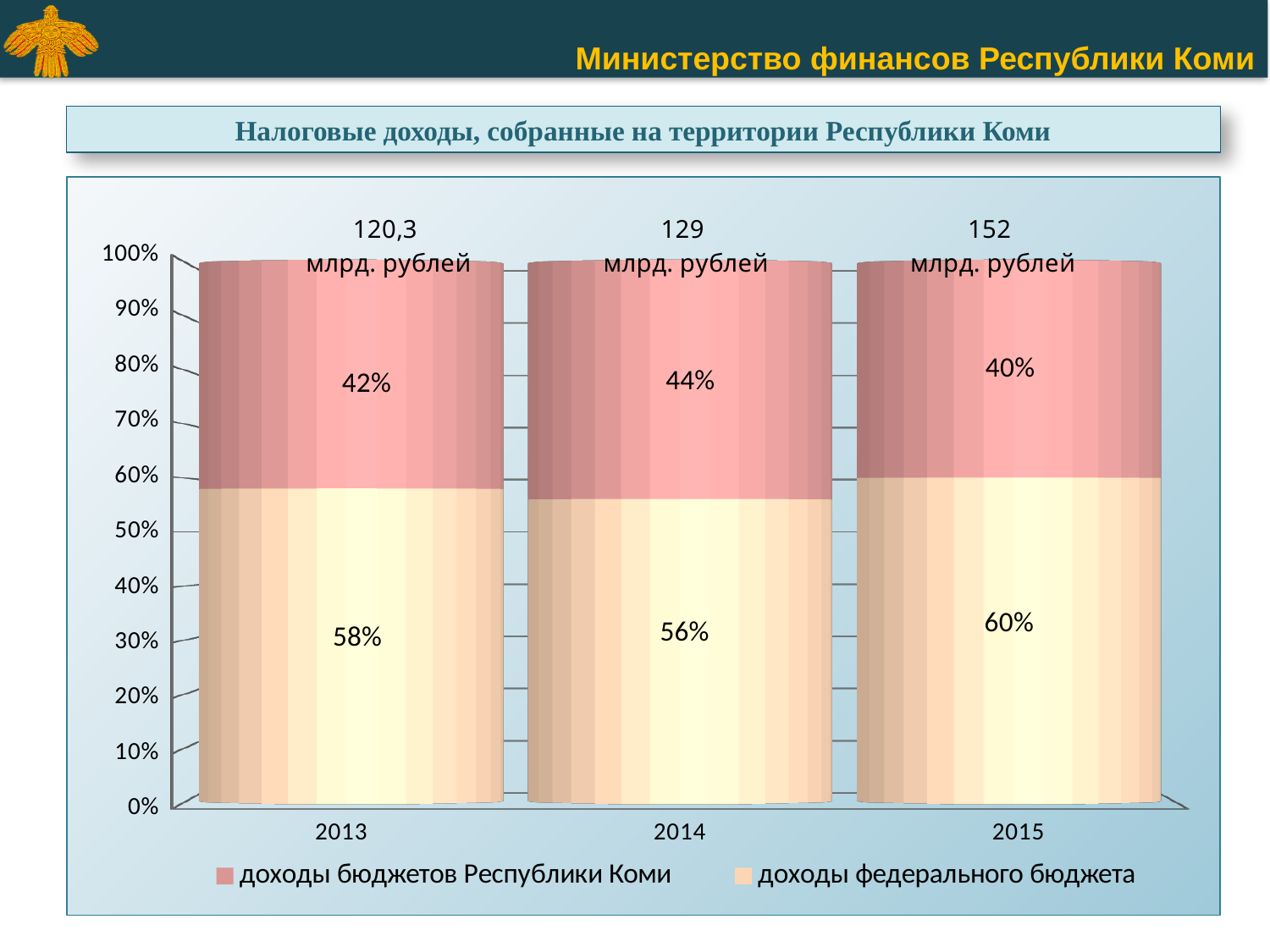
Which was larger in 2013: the share of the federal budget or the share of the budgets of the Republic of Komi? доходы федерального бюджета What kind of chart is shown on the slide? Stacked bar chart What share of tax revenues went to the budgets of the Republic of Komi (доходы бюджетов Республики Коми) in 2013? 42% How many years are shown on the x axis of the chart? 3 What total amount of tax revenues is shown above the bar for 2015? 152 млрд. рублей What total amount of tax revenues is shown above the bar for 2013? 120,3 млрд. рублей In which year was the share of the federal budget (доходы федерального бюджета) the lowest? 2014 In which year was the share of the budgets of the Republic of Komi (доходы бюджетов Республики Коми) the highest? 2014 What share of tax revenues went to the federal budget (доходы федерального бюджета) in 2014? 56% What share of tax revenues went to the federal budget (доходы федерального бюджета) in 2015? 60% How many series does the legend list? 2 By how many percentage points did the share of the federal budget (доходы федерального бюджета) in 2015 exceed its share in 2014? 4